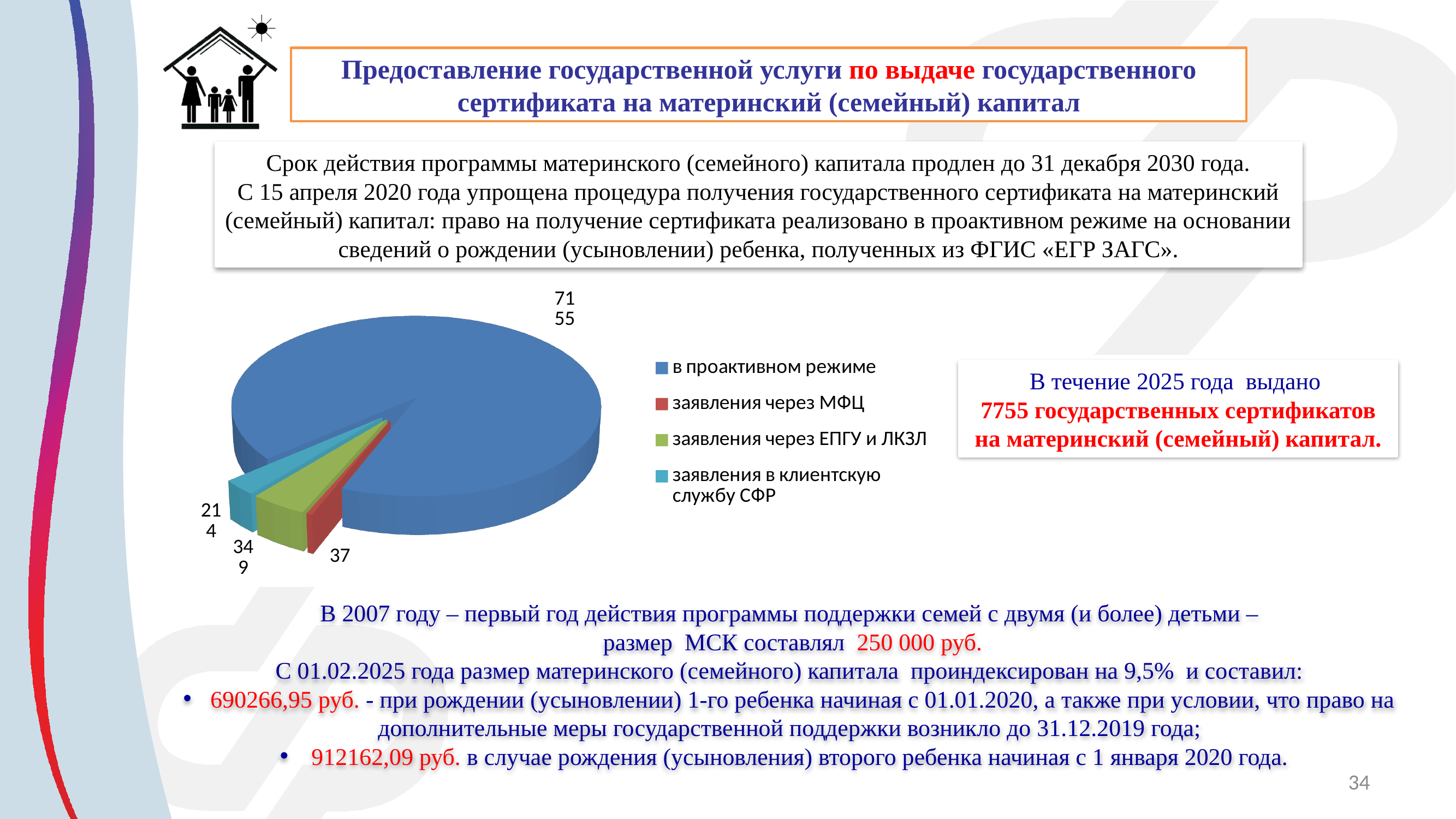
What kind of chart is shown on the slide? pie chart How many entries does the legend of the pie chart list? 4 Which category has the smallest slice in the pie chart? заявления через МФЦ What is the value shown for "в проактивном режиме" in the pie chart? 7155 What is the value shown for "заявления через МФЦ" in the pie chart? 37 How many slices does the pie chart have? 4 What is the difference between the values for "заявления через ЕПГУ и ЛКЗЛ" and "заявления в клиентскую службу СФР" in the pie chart? 135 What colour is the slice for "в проактивном режиме" in the pie chart? blue What is the value shown for "заявления в клиентскую службу СФР" in the pie chart? 214 Which category has the largest slice in the pie chart? в проактивном режиме Which is larger in the pie chart: "заявления через ЕПГУ и ЛКЗЛ" or "заявления в клиентскую службу СФР"? заявления через ЕПГУ и ЛКЗЛ What is the value shown for "заявления через ЕПГУ и ЛКЗЛ" in the pie chart? 349